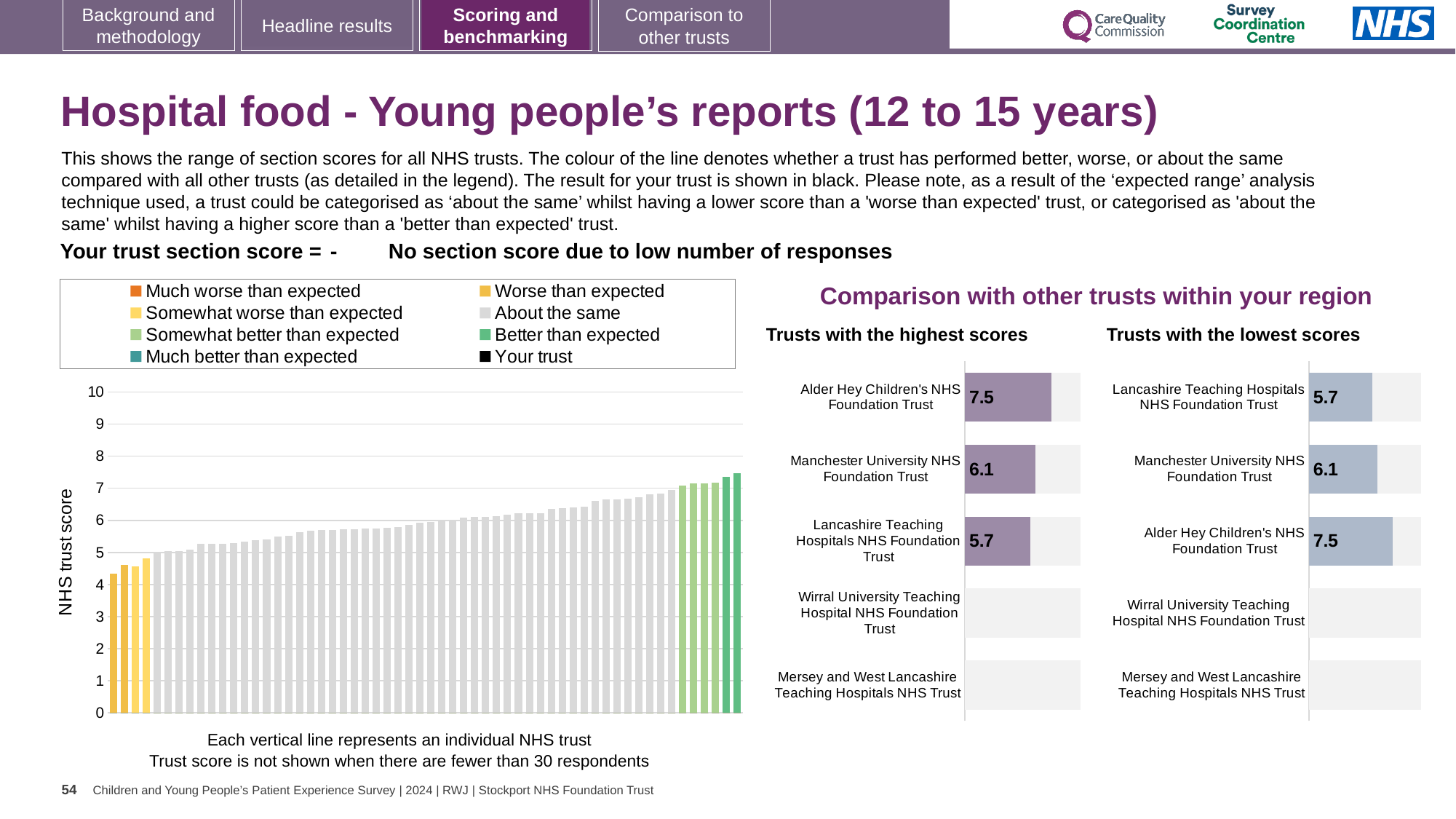
In the 'Trusts with the highest scores' chart, what is the difference between the scores of Alder Hey Children's NHS Foundation Trust and Manchester University NHS Foundation Trust? 1.4 In the 'NHS trust score' chart on the left, do the bar values rise or fall from left to right? Rise In the 'Trusts with the lowest scores' chart, which trust with a score shown has the lowest score? Lancashire Teaching Hospitals NHS Foundation Trust In the 'Trusts with the lowest scores' chart, what is the difference between the scores of Manchester University NHS Foundation Trust and Lancashire Teaching Hospitals NHS Foundation Trust? 0.4 In the 'Trusts with the highest scores' chart, which has a larger score: Manchester University NHS Foundation Trust or Lancashire Teaching Hospitals NHS Foundation Trust? Manchester University NHS Foundation Trust In the 'Trusts with the highest scores' chart, which trust has the highest score? Alder Hey Children's NHS Foundation Trust In the 'Trusts with the lowest scores' chart, what is the score for Lancashire Teaching Hospitals NHS Foundation Trust? 5.7 In the 'Trusts with the highest scores' chart, what is the score for Manchester University NHS Foundation Trust? 6.1 How many trusts are listed in the 'Trusts with the highest scores' chart? 5 In the 'Trusts with the highest scores' chart, what is the score for Alder Hey Children's NHS Foundation Trust? 7.5 What kind of chart is the 'NHS trust score' chart on the left of the slide? Bar chart In the 'NHS trust score' chart on the left, is the value of the leftmost bar greater or less than 5? less